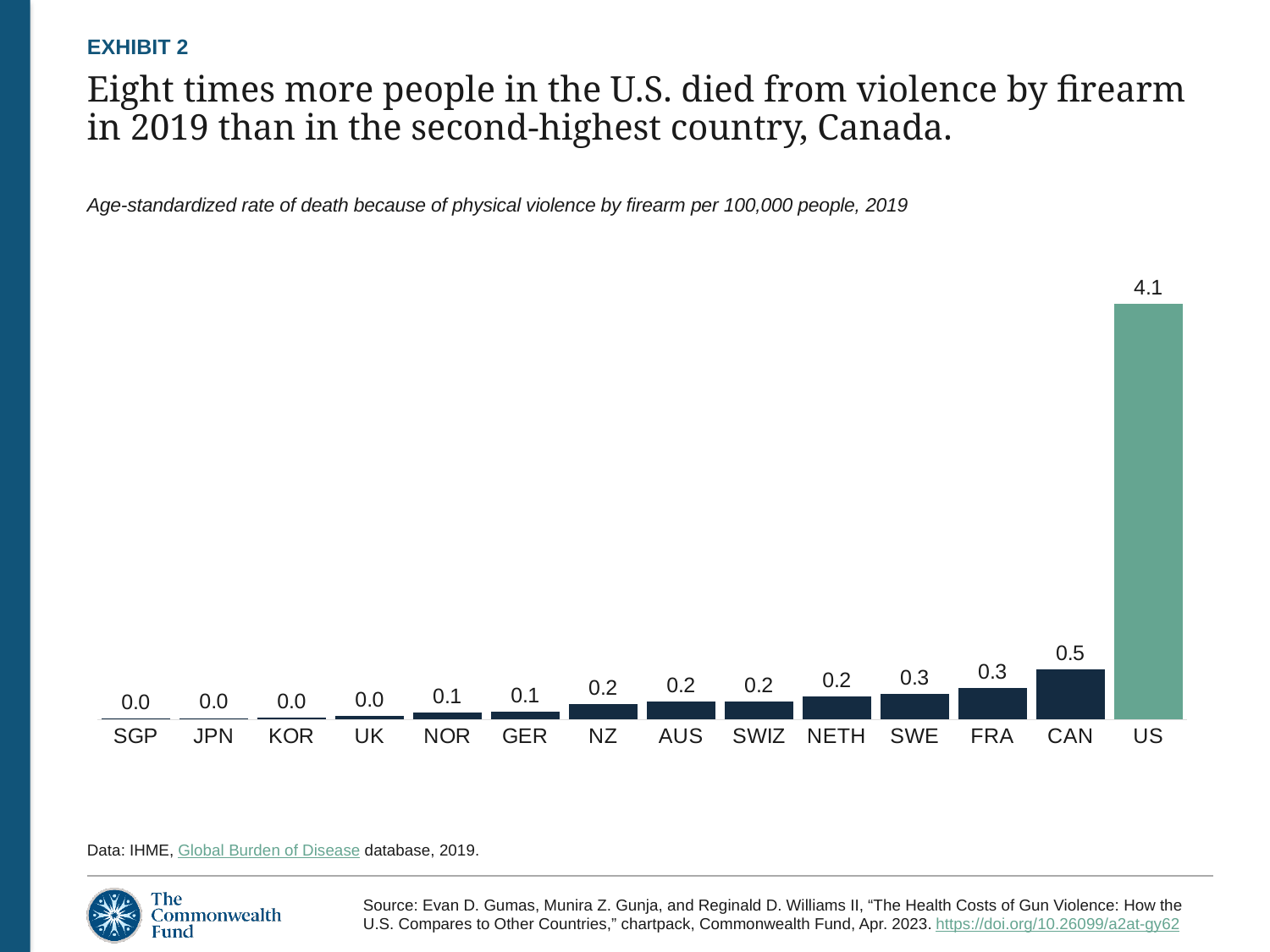
What is the difference between the values for FRA and GER? 0.2 Which is larger, the value for CAN or the value for NETH? CAN How many countries are shown on the chart? 14 Do the values rise or fall from left to right along the x axis? Rise What is the value for CAN? 0.5 What is the value for SWE? 0.3 Which country has the highest value? US What is the difference between the values for the US and CAN? 3.6 What is the value for the US? 4.1 What kind of chart is this? Bar chart What is the subtitle describing the measure plotted on the chart? Age-standardized rate of death because of physical violence by firearm per 100,000 people, 2019 What is the value for NOR? 0.1